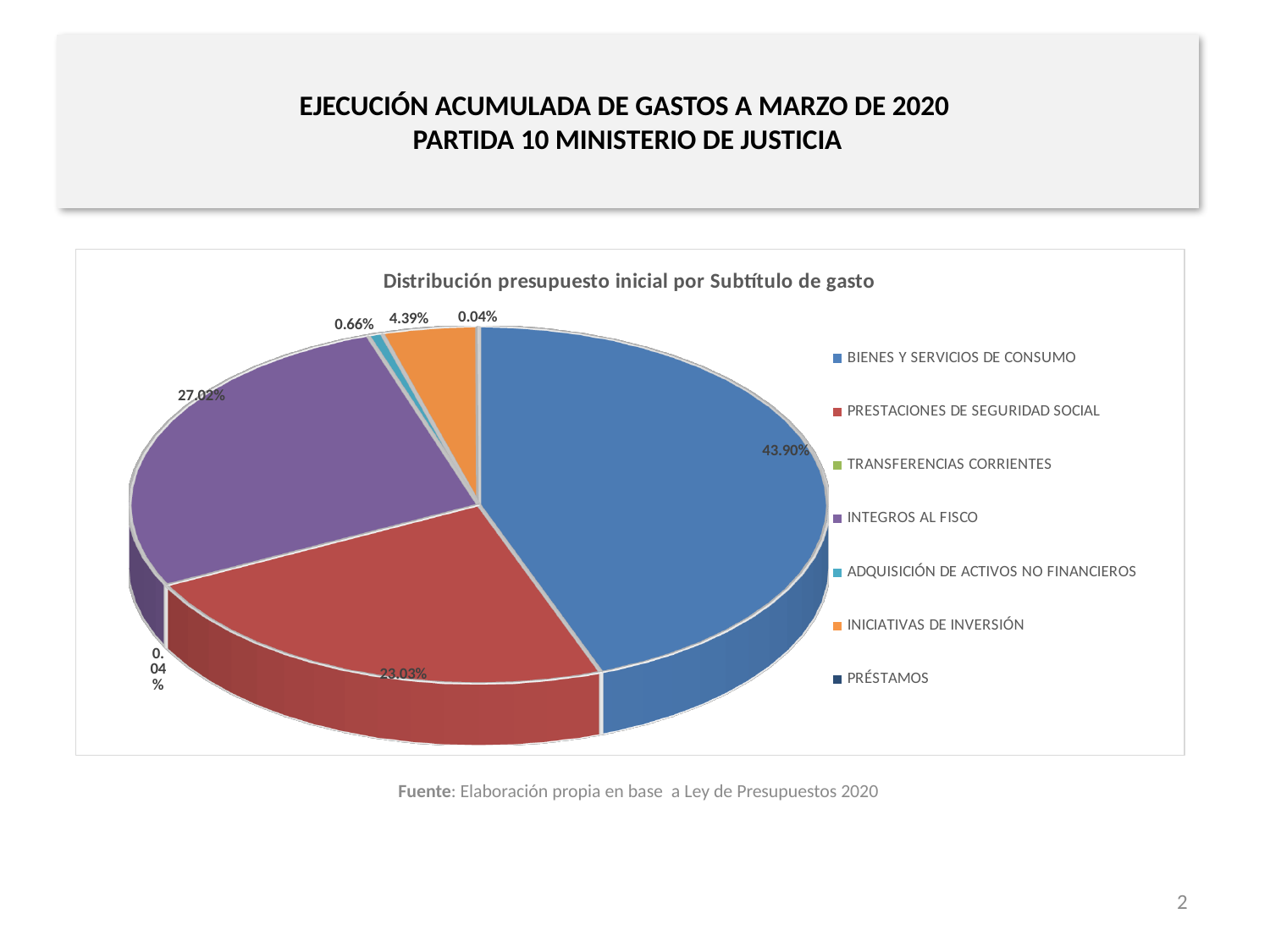
What share of the pie does PRESTACIONES DE SEGURIDAD SOCIAL represent? 23.03% What share of the pie does BIENES Y SERVICIOS DE CONSUMO represent? 43.90% What type of chart is shown on the slide? pie chart Which is larger, the share for INTEGROS AL FISCO or the share for PRESTACIONES DE SEGURIDAD SOCIAL? INTEGROS AL FISCO What colour is the slice for INICIATIVAS DE INVERSIÓN? orange What is the title of the chart? Distribución presupuesto inicial por Subtítulo de gasto What is the difference between the share for BIENES Y SERVICIOS DE CONSUMO and the share for INTEGROS AL FISCO? 16.88% What share of the pie does ADQUISICIÓN DE ACTIVOS NO FINANCIEROS represent? 0.66% How many categories does the legend of the pie chart list? 7 Which category has the largest share of the pie? BIENES Y SERVICIOS DE CONSUMO What share of the pie does INICIATIVAS DE INVERSIÓN represent? 4.39% What share of the pie does INTEGROS AL FISCO represent? 27.02%